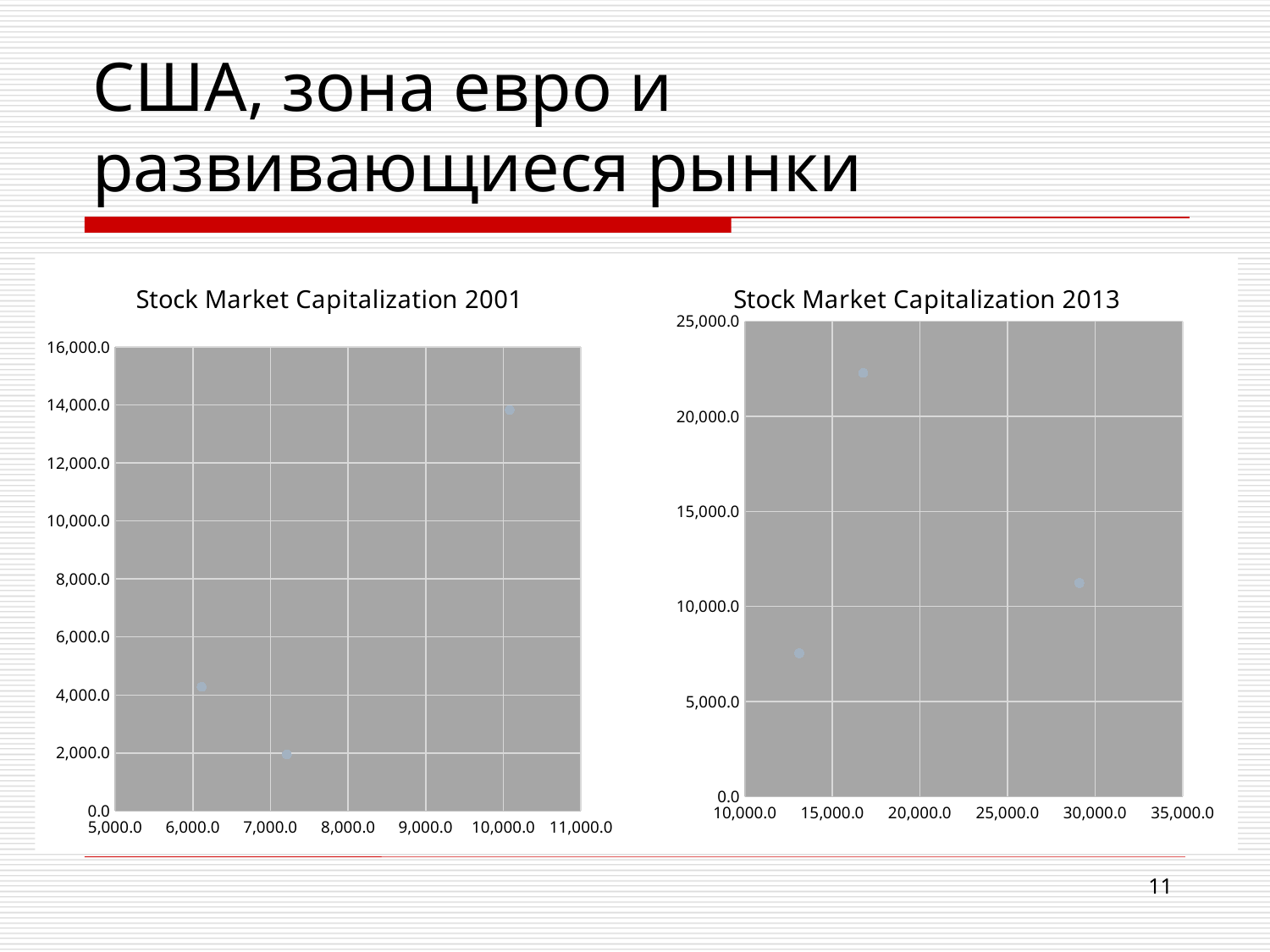
In the 'Stock Market Capitalization 2013' chart, is the x value of the rightmost point greater or less than 25,000.0? greater What kind of chart is the 'Stock Market Capitalization 2013' chart? scatter chart In the 'Stock Market Capitalization 2001' chart, is the y value of the highest point greater or less than 12,000.0? greater How many data points are plotted on the 'Stock Market Capitalization 2013' chart? 3 In the 'Stock Market Capitalization 2013' chart, is the y value of the lowest point greater or less than 10,000.0? less In the 'Stock Market Capitalization 2001' chart, how many points have a y value above 10,000.0? 1 What kind of chart is the 'Stock Market Capitalization 2001' chart? scatter chart How many data points are plotted on the 'Stock Market Capitalization 2001' chart? 3 What is the highest value shown on the y axis of the 'Stock Market Capitalization 2013' chart? 25,000.0 What is the title of the chart on the left side of the slide? Stock Market Capitalization 2001